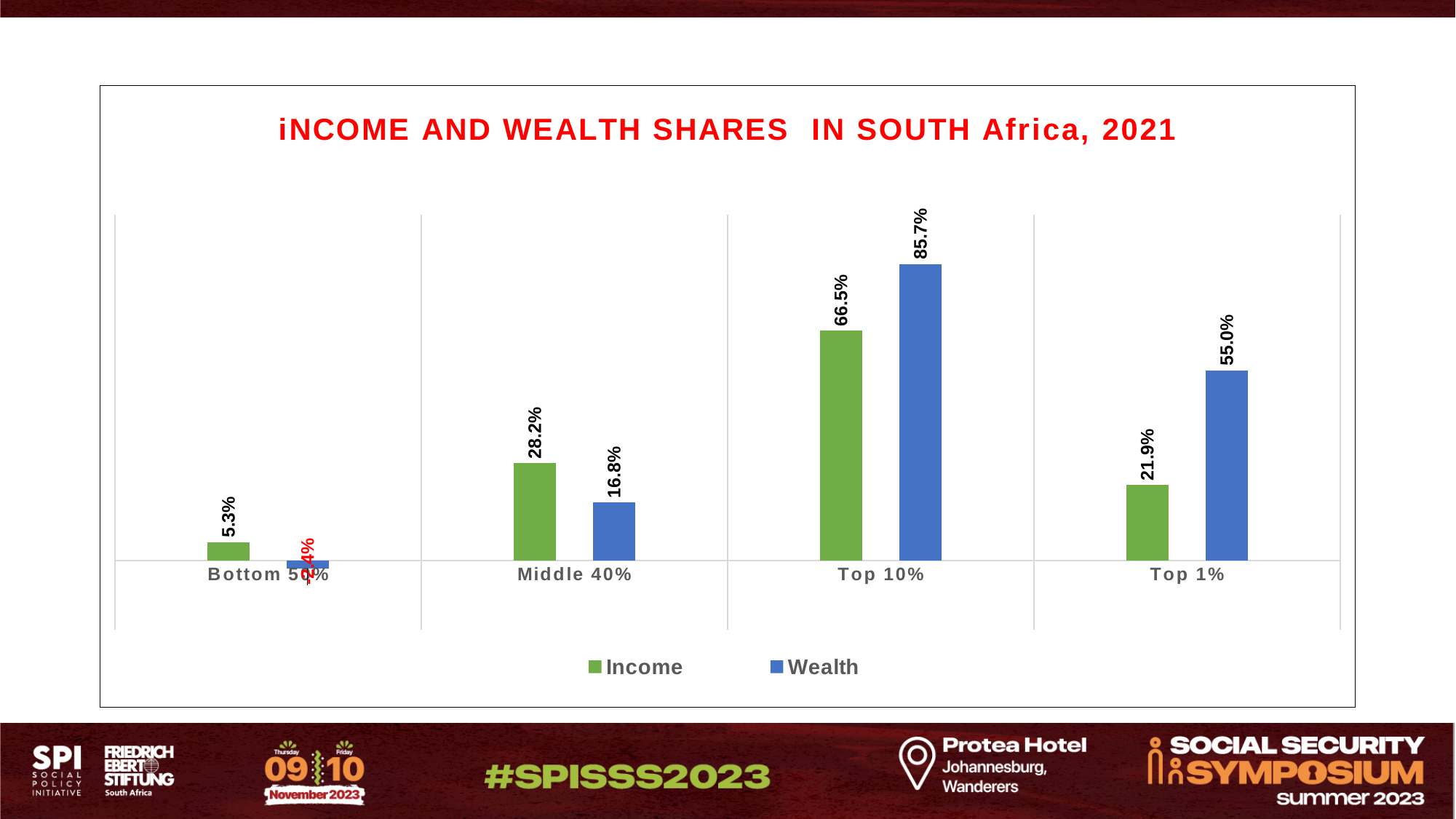
What is the Wealth share for the Top 1%? 55.0% What type of chart is shown on the slide? Bar chart What is the Income share for the Bottom 50%? 5.3% What is the Income share for the Middle 40%? 28.2% How many series does the legend list? 2 What is the Wealth share for the Middle 40%? 16.8% Which category has the lowest Income share? Bottom 50% For the Middle 40%, which is larger, the Income share or the Wealth share? Income What is the Income share for the Top 10%? 66.5% What is the difference between the Wealth share and the Income share for the Top 10%? 19.2% How many categories are shown on the x axis? 4 Which category has the highest Wealth share? Top 10%